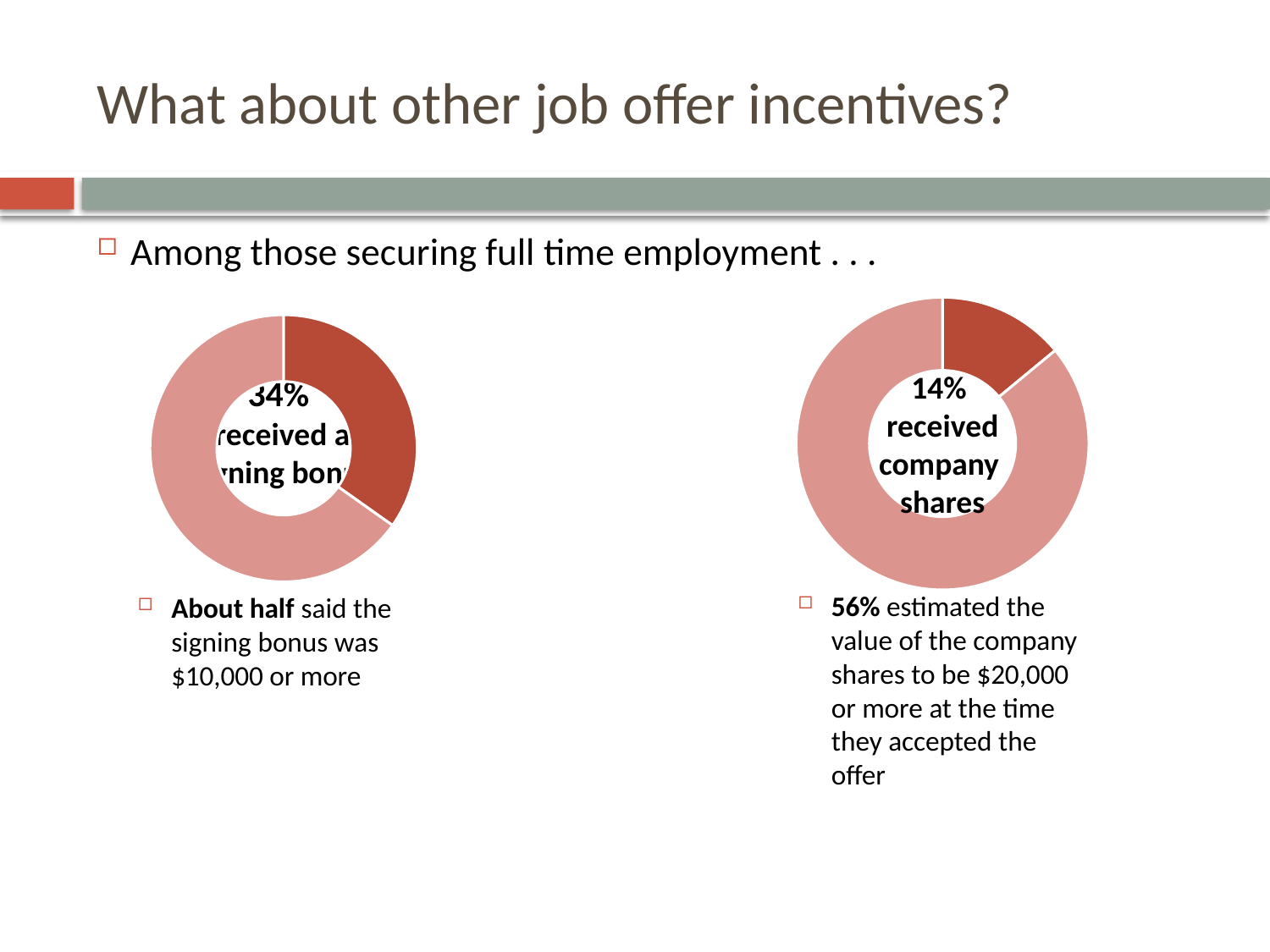
What is the difference between the percentage who received a signing bonus (left chart) and the percentage who received company shares (right chart)? 20 percentage points What kind of chart is the left chart on the slide? pie chart (donut) In the right chart, is the dark red slice larger or smaller than the light pink slice? smaller In the right chart, what colour is the slice representing those who received company shares? dark red In the right chart, what percentage received company shares? 14% How many slices does the right chart have? 2 In the left chart, what percentage received a signing bonus? 34% How many slices does the left chart have? 2 Which is larger: the percentage who received a signing bonus (left chart) or the percentage who received company shares (right chart)? received a signing bonus How many charts are shown on the slide? 2 In the left chart, which slice is larger, the dark red one or the light pink one? the light pink one